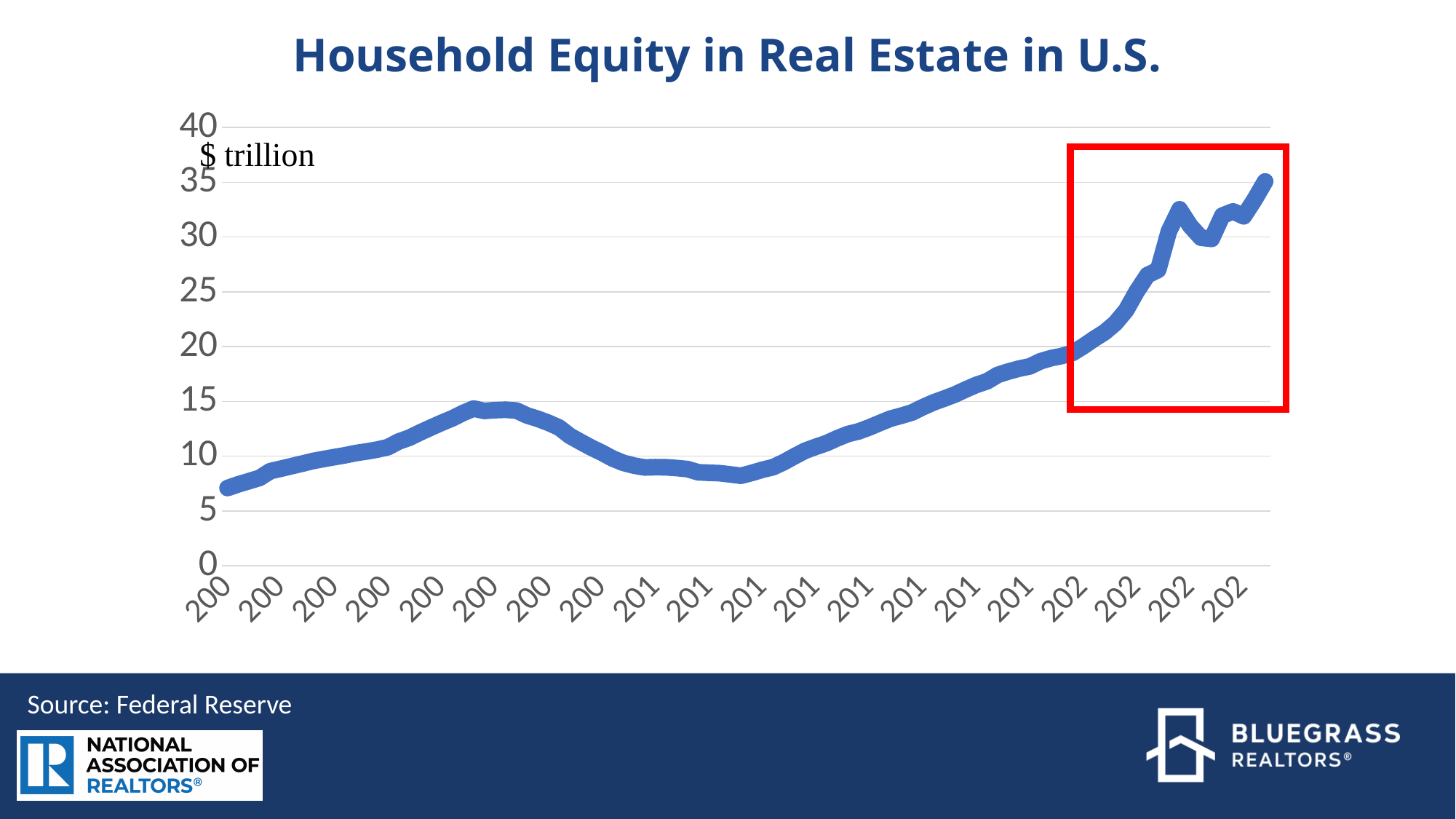
Is the highest value on the chart greater or less than 25? greater Is the value at the left end of the line greater or less than 10? less Is the lowest value in the dip near the middle of the chart greater or less than 10? less What is the title of the chart? Household Equity in Real Estate in U.S. Which is larger, the value at the right end of the line or the value at the left end of the line? the right end What unit is shown on the vertical axis of the chart? $ trillion Where along the x axis does the line reach its lowest value, near the left end, the middle, or the right end? the left end What kind of chart is shown on the slide? line chart Where along the x axis does the line reach its highest value, near the left end, the middle, or the right end? the right end What is the highest value shown on the vertical axis? 40 Overall, do the values rise or fall from the left end of the x axis to the right end? rise